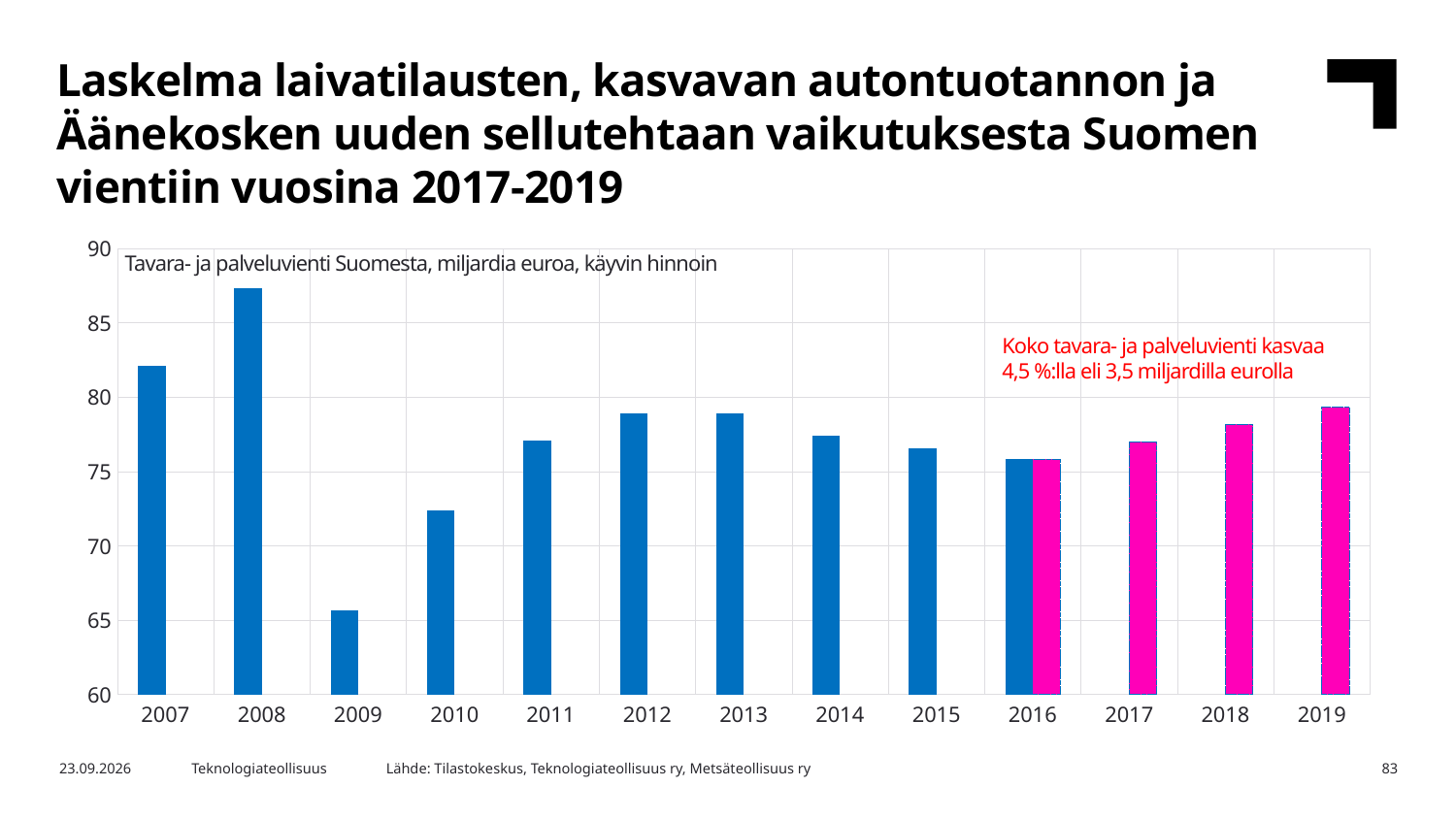
Is the value for 2019 greater or less than 80? less How many years are shown on the x axis of the chart? 13 Which year has the highest export value in the chart? 2008 Which year has the larger value, 2007 or 2010? 2007 Which year has the larger value, 2016 or 2019? 2019 What kind of chart is shown on the slide? Bar chart Is the value for 2008 greater or less than 85? greater Do the values rise or fall from 2016 to 2019? rise Is the value for 2009 greater or less than 70? less Which year has the lowest export value in the chart? 2009 According to the red annotation on the chart, by how many billion euros does total goods and services export grow? 3,5 miljardilla eurolla